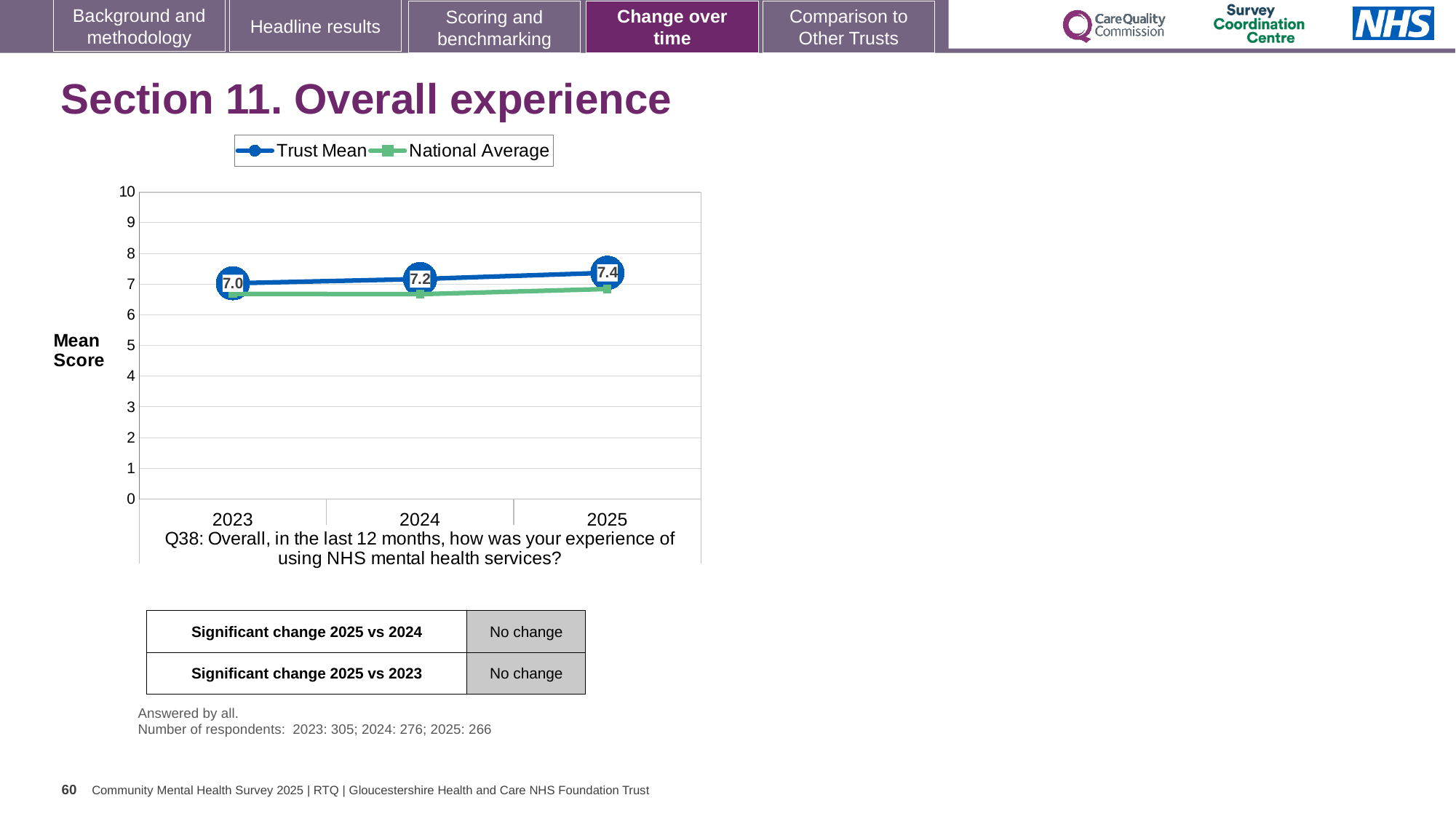
In 2025, which is larger: the Trust Mean or the National Average? Trust Mean In which year is the Trust Mean score lowest? 2023 What kind of chart is shown on the slide? Line chart In which year is the Trust Mean score highest? 2025 What is the Trust Mean score for 2025? 7.4 How many years are plotted on the x axis? 3 How many series does the legend list? 2 What is the difference between the Trust Mean score in 2025 and in 2023? 0.4 What is the Trust Mean score for 2024? 7.2 Does the Trust Mean rise or fall from 2023 to 2025? Rise Is the National Average value for 2023 greater or less than 7? less What is the Trust Mean score for 2023? 7.0